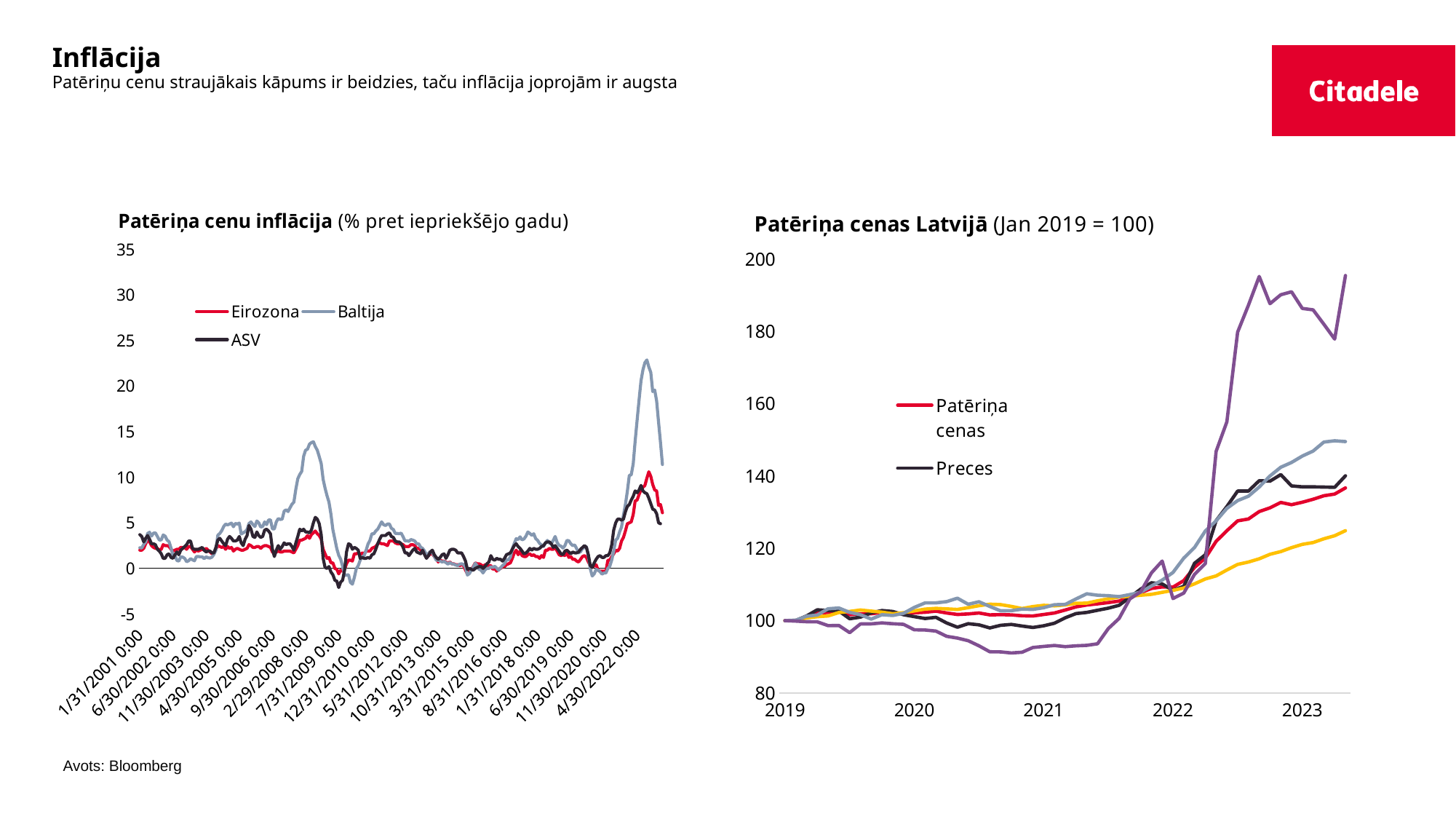
In the right chart "Patēriņa cenas Latvijā", is the last value of Patēriņa cenas greater or less than 140? less In the left chart "Patēriņa cenu inflācija", which series reaches the highest peak? Baltija What kind of chart is the right chart titled "Patēriņa cenas Latvijā"? line chart In the right chart "Patēriņa cenas Latvijā", does the Patēriņa cenas series rise or fall from 2019 to 2023? rise What is the base value stated in the title of the right chart "Patēriņa cenas Latvijā"? Jan 2019 = 100 What kind of chart is the left chart titled "Patēriņa cenu inflācija"? line chart How many series does the legend of the left chart "Patēriņa cenu inflācija" list? 3 How many series does the legend of the right chart "Patēriņa cenas Latvijā" list? 2 In the left chart "Patēriņa cenu inflācija", is the peak value of Baltija in 2022 greater or less than 20? greater In the left chart "Patēriņa cenu inflācija", at the last data point, which series is higher: Baltija or Eirozona? Baltija In the left chart "Patēriņa cenu inflācija", is the peak value of ASV in 2022 greater or less than 10? less